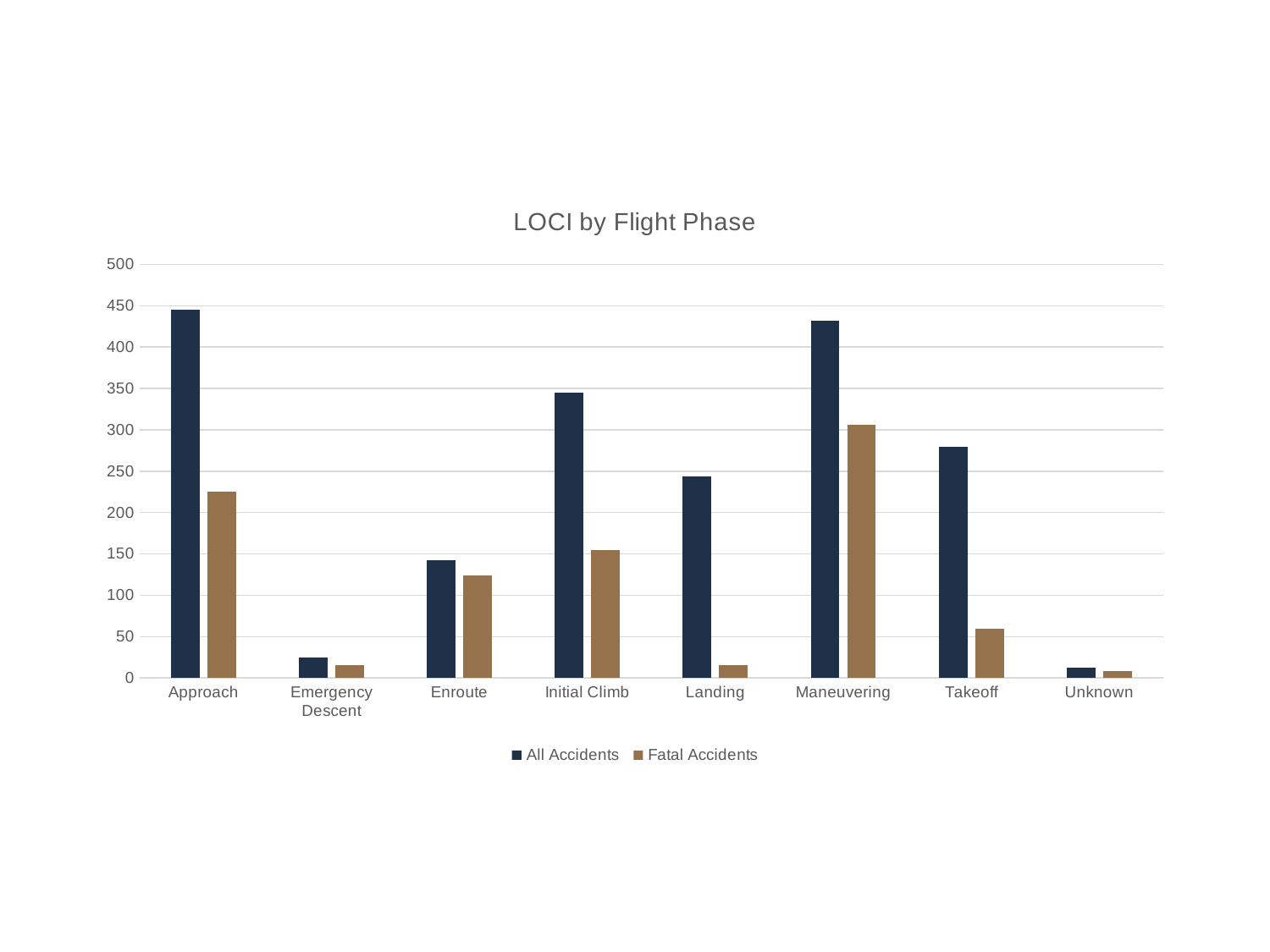
How many series does the legend list? 2 Is the Fatal Accidents value for Maneuvering greater or less than 250? greater Is the All Accidents value for Approach greater or less than 400? greater Is the All Accidents value for Takeoff greater or less than 250? greater What kind of chart is shown on the slide? bar chart What is the title of the chart? LOCI by Flight Phase Which is larger, the All Accidents value for Landing or for Takeoff? Takeoff Which flight phase has the highest value for Fatal Accidents? Maneuvering Which is larger, the Fatal Accidents value for Approach or for Maneuvering? Maneuvering Which flight phase has the lowest value for All Accidents? Unknown How many flight phase categories are shown on the x axis? 8